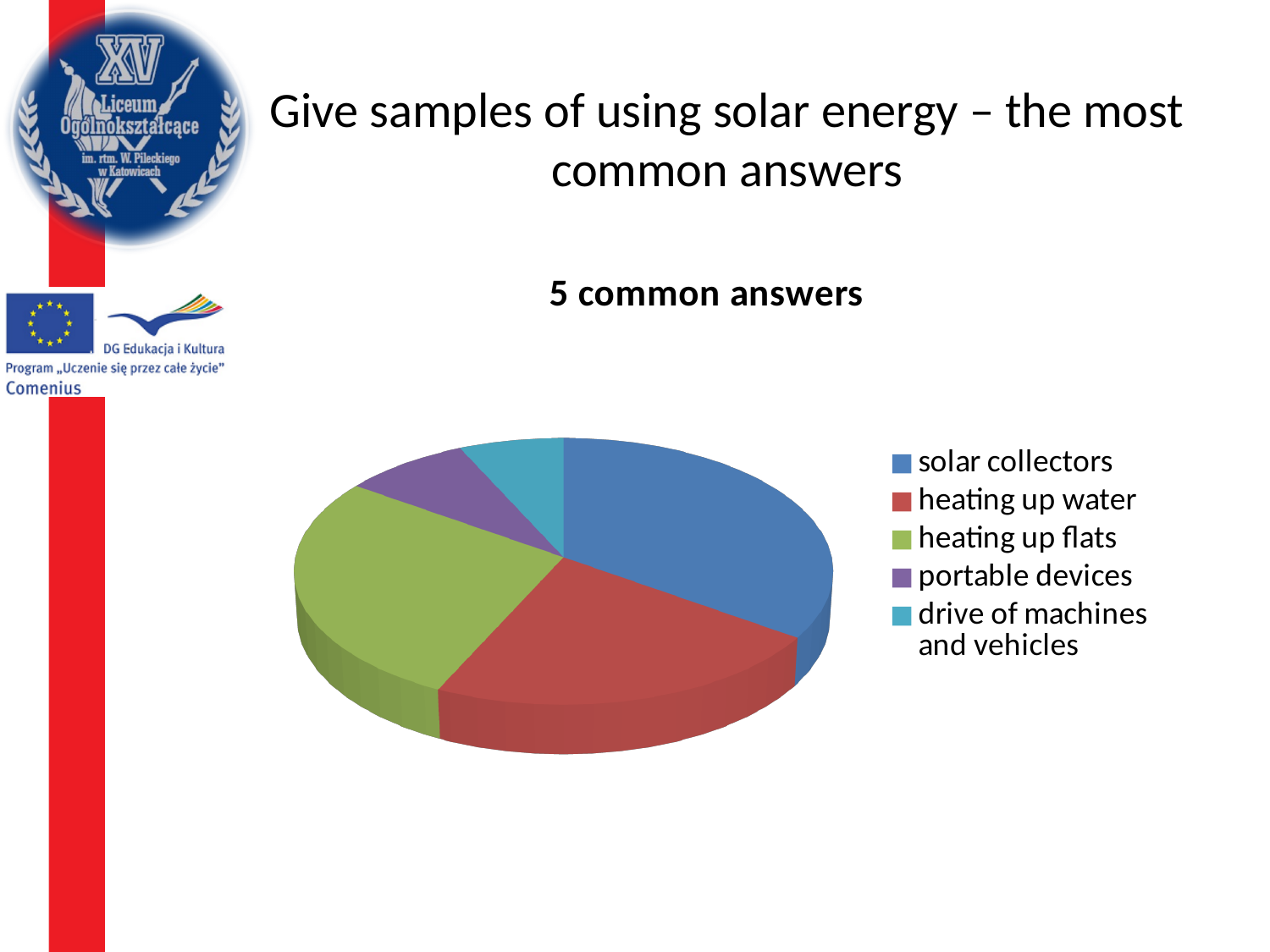
Which slice is larger, heating up water or drive of machines and vehicles? heating up water Which category has the largest slice in the pie chart? solar collectors How many entries does the legend of the pie chart list? 5 Which slice is larger, heating up flats or drive of machines and vehicles? heating up flats How many slices does the pie chart have? 5 What is the title of the pie chart? 5 common answers Which colour represents heating up flats in the pie chart? green Which slice is larger, solar collectors or heating up flats? solar collectors What kind of chart is shown on the slide? pie chart